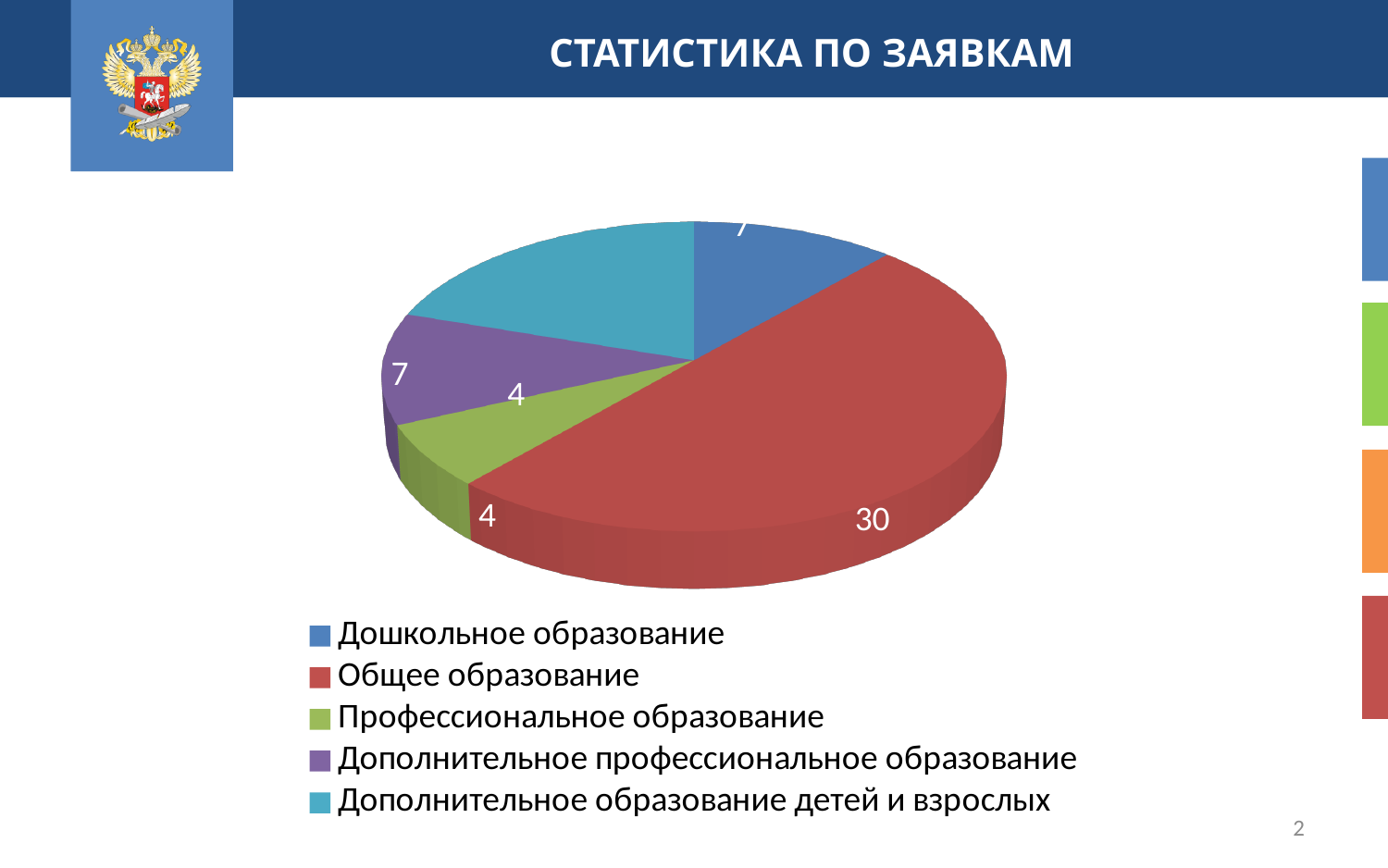
What is the value for Дополнительное профессиональное образование in the pie chart? 7 What colour is the slice for Общее образование in the pie chart? red Which is larger: the slice for Дополнительное образование детей и взрослых or the slice for Профессиональное образование? Дополнительное образование детей и взрослых Which category has the largest slice in the pie chart? Общее образование What is the difference between the values for Общее образование and Дополнительное профессиональное образование? 23 How many categories does the pie chart's legend list? 5 What is the difference between the values for Общее образование and Профессиональное образование? 26 What type of chart is shown on the slide? pie chart What is the value for Профессиональное образование in the pie chart? 4 What is the value for Общее образование in the pie chart? 30 Which category has the smallest slice in the pie chart? Профессиональное образование What is the title of the slide containing the pie chart? СТАТИСТИКА ПО ЗАЯВКАМ